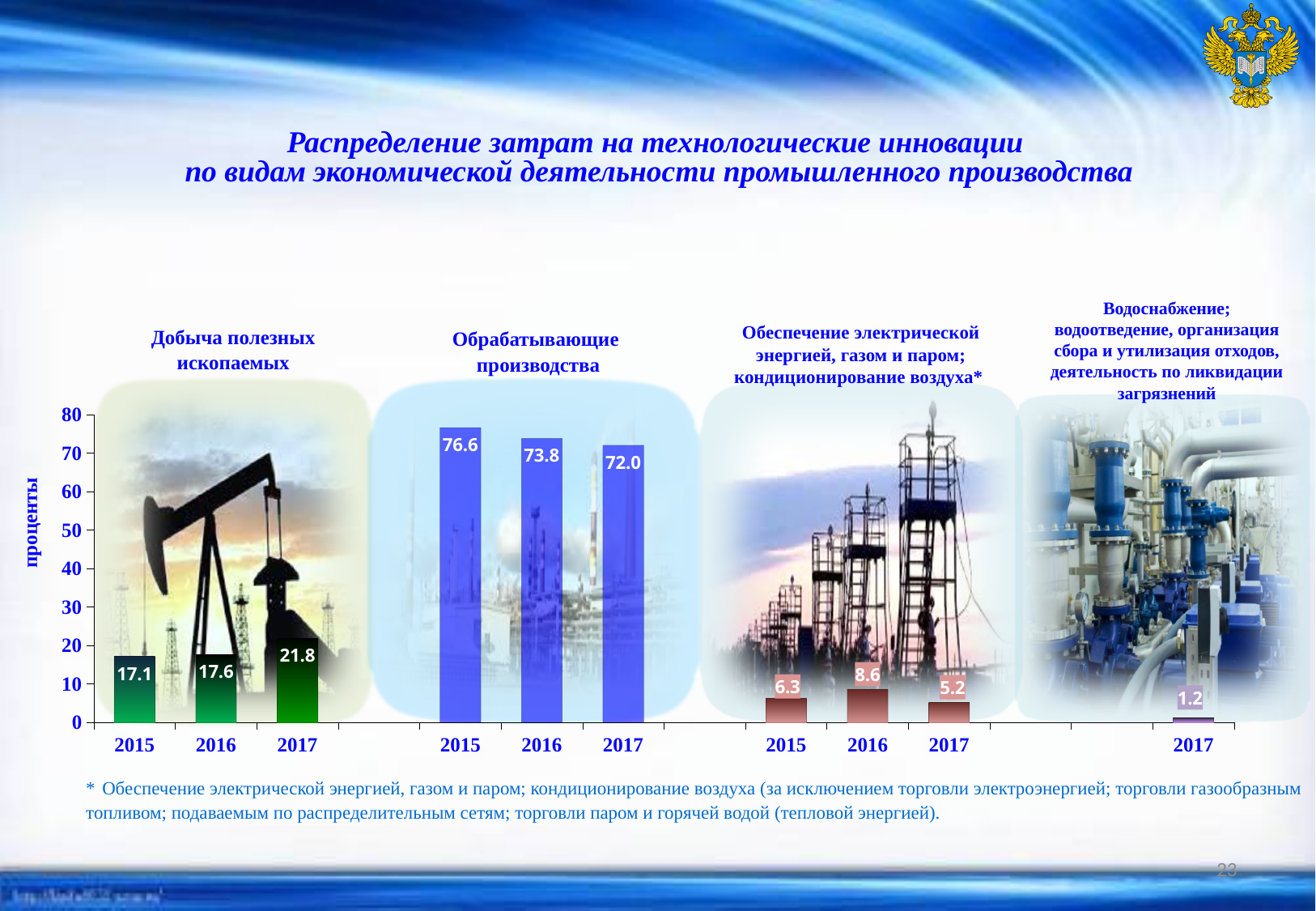
What kind of chart is shown on the slide? bar chart What is the difference between the 2017 and 2015 values for Добыча полезных ископаемых? 4.7 What is the value for Обеспечение электрической энергией, газом и паром; кондиционирование воздуха in 2016? 8.6 Which is larger: the 2016 value for Добыча полезных ископаемых or the 2016 value for Обеспечение электрической энергией, газом и паром? Добыча полезных ископаемых What is the difference between the 2015 and 2017 values for Обрабатывающие производства? 4.6 Do the values for Добыча полезных ископаемых rise or fall from 2015 to 2017? rise What is the value for Добыча полезных ископаемых in 2017? 21.8 What is the label of the vertical axis? проценты What is the value shown for Водоснабжение; водоотведение, организация сбора и утилизация отходов in 2017? 1.2 What is the value for Обрабатывающие производства in 2015? 76.6 Which year has the highest value for Обрабатывающие производства? 2015 Which year has the lowest value for Обеспечение электрической энергией, газом и паром; кондиционирование воздуха? 2017